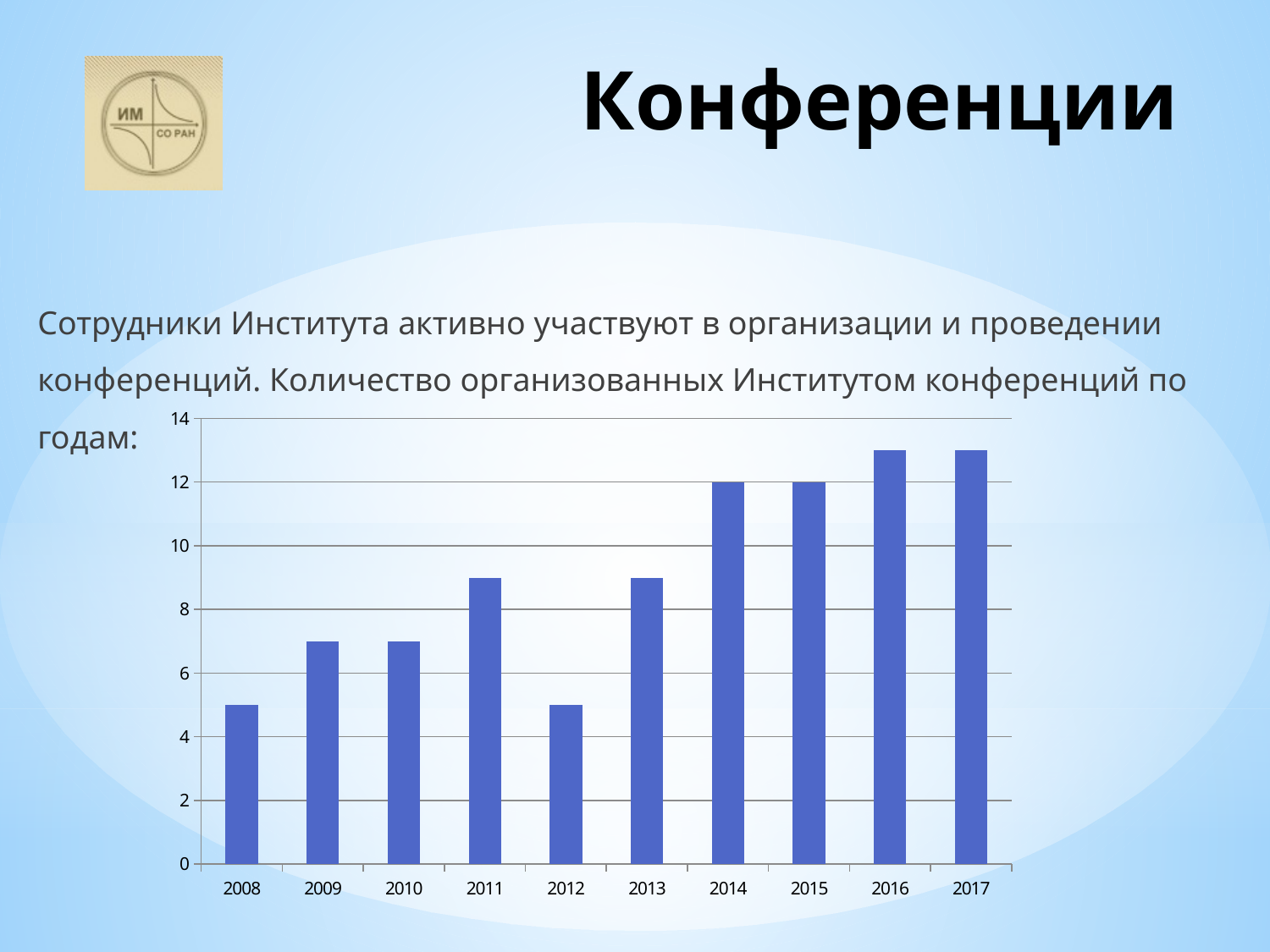
How many years are shown on the x axis of the chart? 10 Is the value for 2008 greater or less than 6? less Do the values generally rise or fall from 2008 to 2017? rise What kind of chart is shown on the slide? bar chart What is the value for 2015? 12 Is the value for 2016 greater or less than 12? greater Is the value for 2009 greater or less than 6? greater What is the value for 2014? 12 Which is larger, the value for 2012 or the value for 2013? 2013 Which is larger, the value for 2014 or the value for 2011? 2014